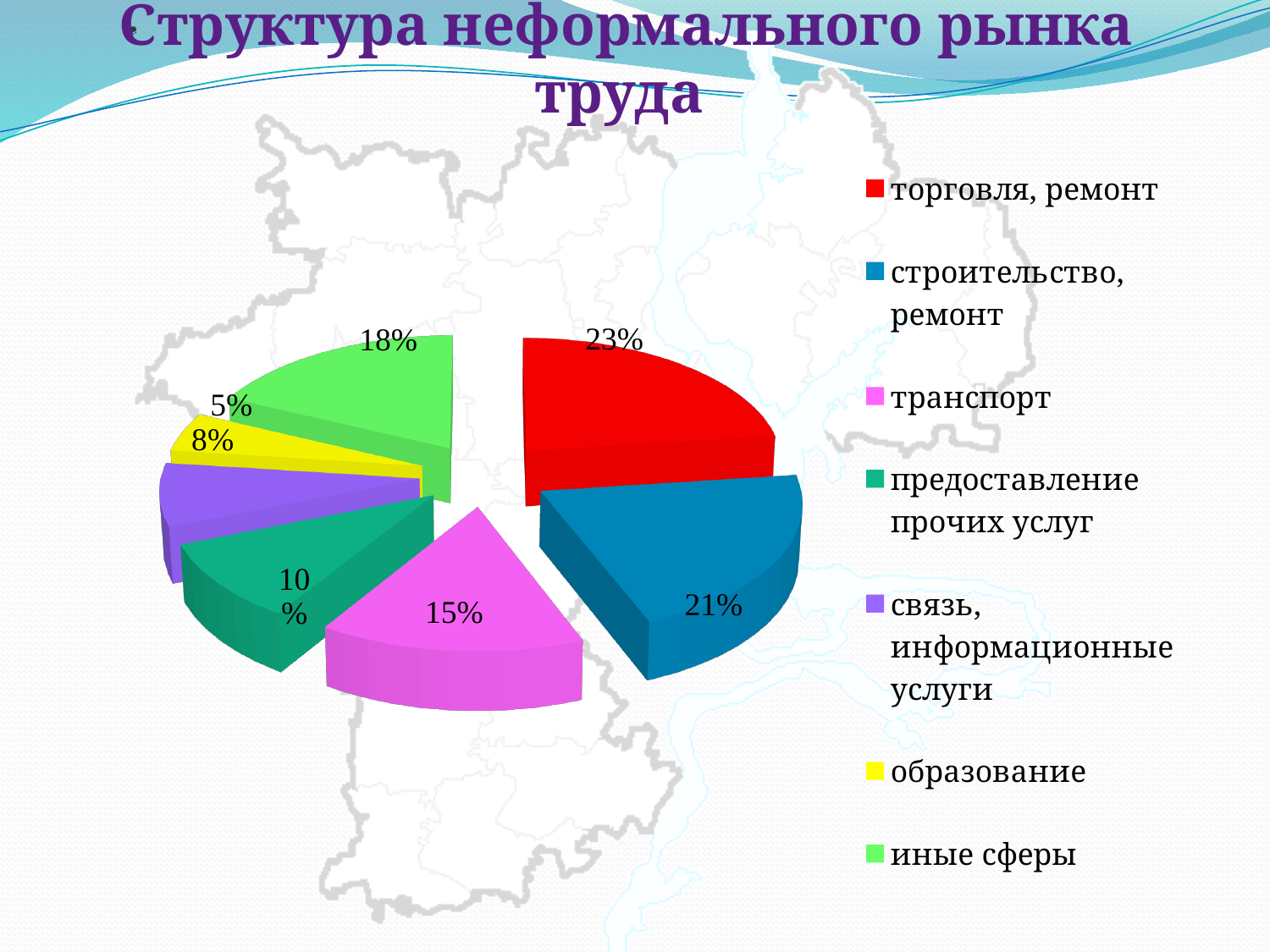
What colour is the slice for образование? yellow What is the value for иные сферы? 18% How many categories does the legend list? 7 What share of the pie does строительство, ремонт have? 21% What is the value for предоставление прочих услуг? 10% What kind of chart is shown on the slide? pie chart What share of the pie does торговля, ремонт have? 23% Which category has the smallest share of the pie? образование Which is larger, the share for иные сферы or the share for транспорт? иные сферы What is the value for транспорт? 15% What is the difference between the shares of торговля, ремонт and транспорт? 8% Which category has the largest share of the pie? торговля, ремонт